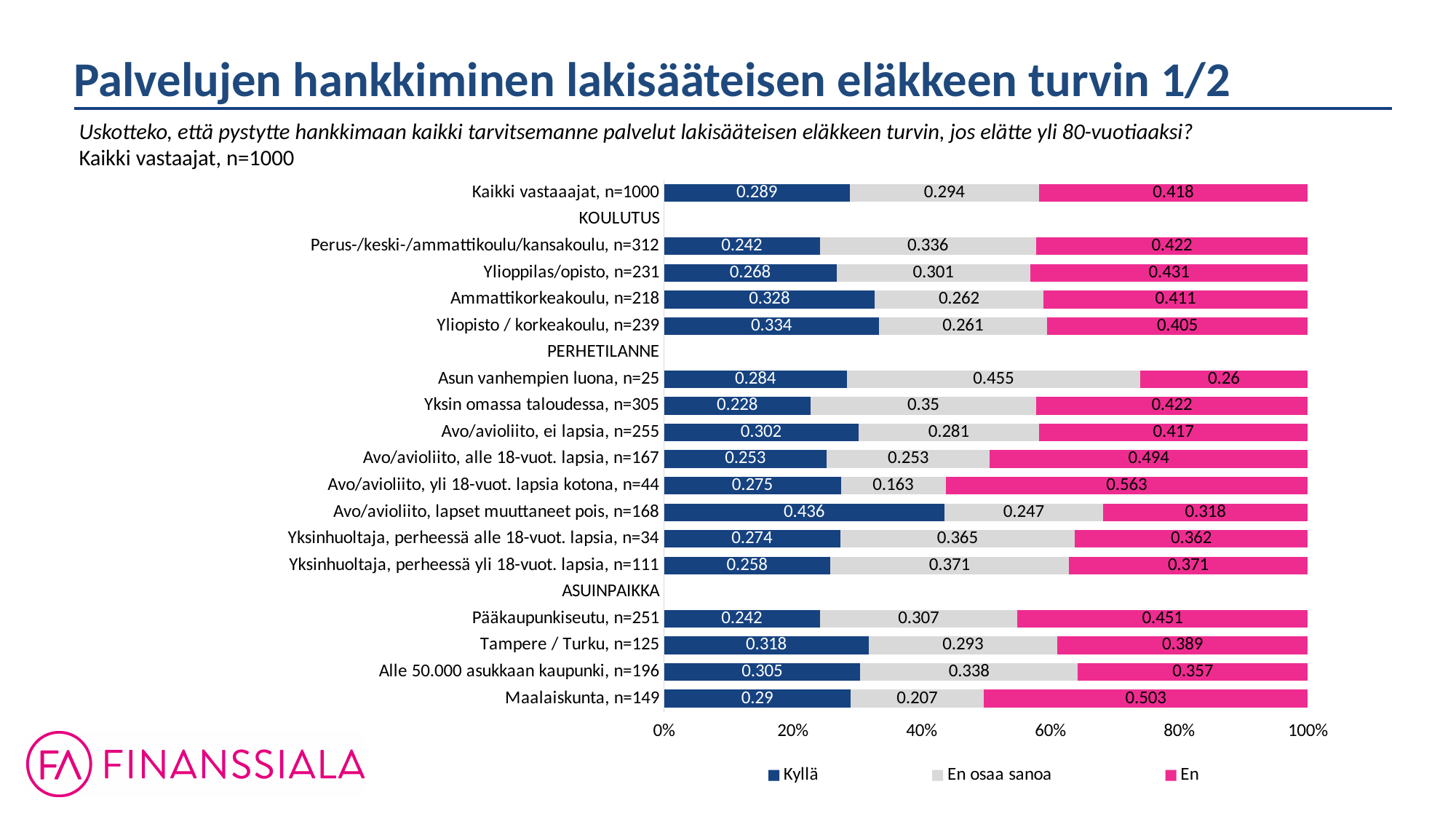
What are the three legend entries of the chart? Kyllä, En osaa sanoa, En What is the difference between the En value and the Kyllä value for Pääkaupunkiseutu, n=251? 0.209 What is the En value for Maalaiskunta, n=149? 0.503 How many series does the legend list? 3 Which category has the highest En value? Avo/avioliito, yli 18-vuot. lapsia kotona, n=44 What kind of chart is shown on the slide? Stacked bar chart What is the Kyllä value for Kaikki vastaaajat, n=1000? 0.289 What is the En osaa sanoa value for Asun vanhempien luona, n=25? 0.455 Is the Kyllä value for Avo/avioliito, lapset muuttaneet pois, n=168 greater or less than 40%? greater Which has the larger Kyllä value: Tampere / Turku, n=125 or Pääkaupunkiseutu, n=251? Tampere / Turku, n=125 Which category has the highest Kyllä value? Avo/avioliito, lapset muuttaneet pois, n=168 Which category has the lowest Kyllä value? Yksin omassa taloudessa, n=305